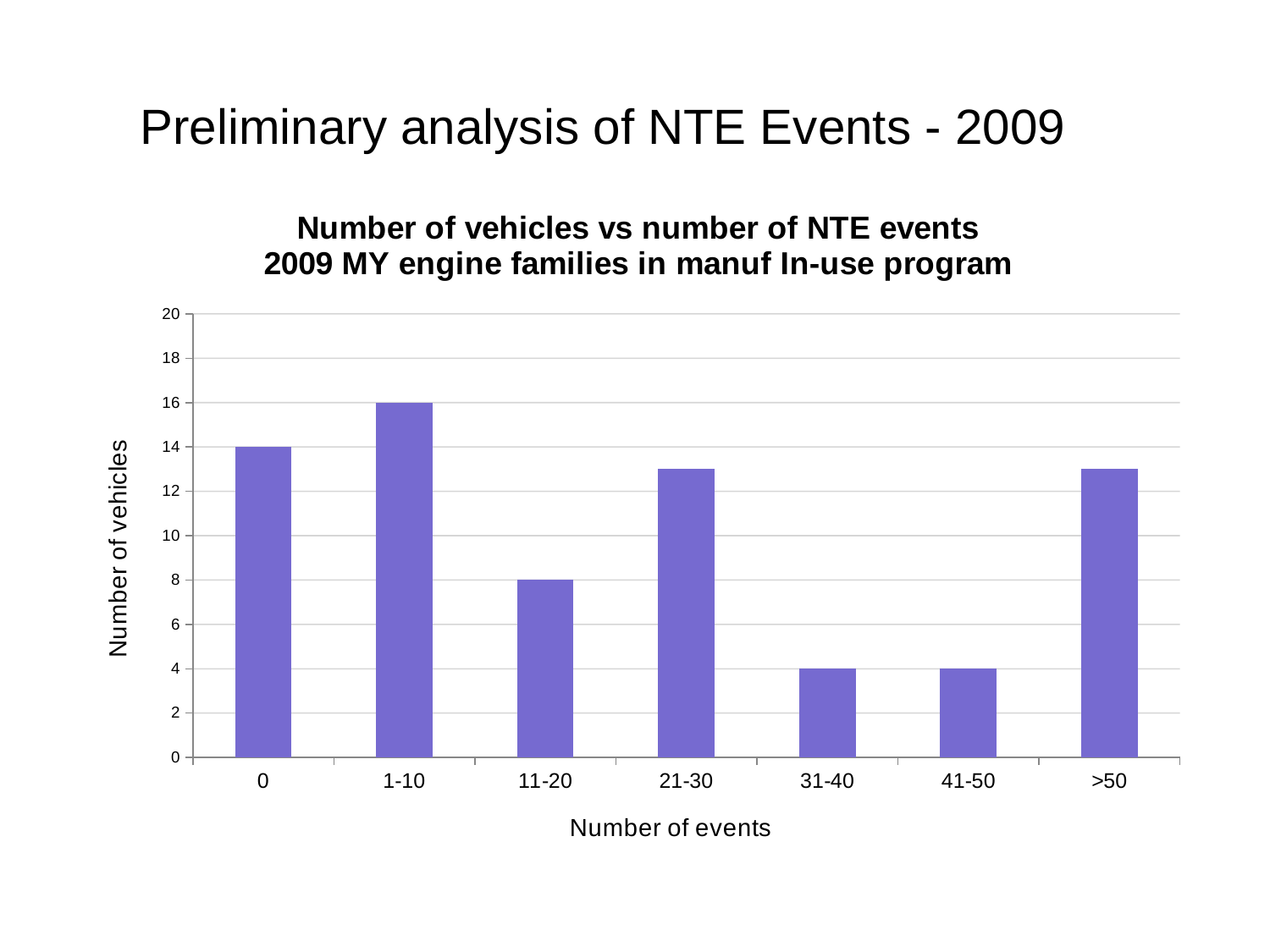
How many number-of-events categories are shown on the x axis? 7 What is the number of vehicles for the 1-10 events category? 16 What is the number of vehicles for the 31-40 events category? 4 Is the number of vehicles for the 21-30 category greater or less than 12? greater What is the difference in number of vehicles between the 11-20 and 41-50 categories? 4 What kind of chart is shown on the slide? Bar chart What is the difference in number of vehicles between the 1-10 and 0 categories? 2 Which has more vehicles, the 0 category or the 11-20 category? 0 Which number-of-events category has the highest number of vehicles? 1-10 Is the number of vehicles for the >50 category greater or less than 14? less What is the number of vehicles for the 0 events category? 14 What is the number of vehicles for the 11-20 events category? 8